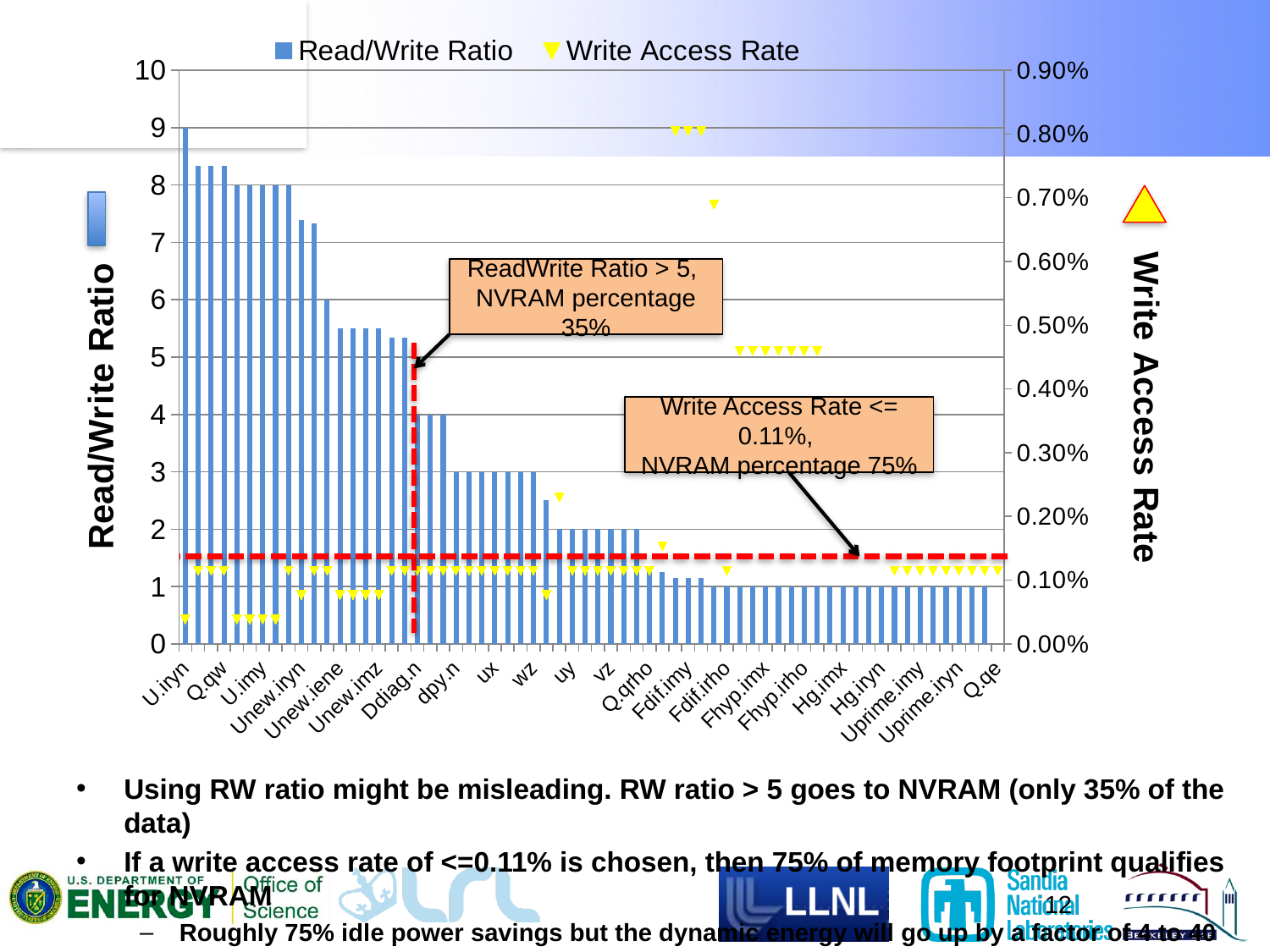
Do the Read/Write Ratio bars rise or fall from left to right along the x axis? fall How many series does the chart legend list? 2 Is the Read/Write Ratio for Q.qw greater or less than 8? greater Is the Read/Write Ratio for dpy.n greater or less than 5? less Is the Read/Write Ratio for U.iryn greater or less than 8? greater Which has the larger Read/Write Ratio, Q.qw or Q.qe? Q.qw Which category has the highest Read/Write Ratio bar? U.iryn What is the title of the right-hand vertical axis? Write Access Rate What kind of chart is shown on the slide? bar chart Which has the larger Read/Write Ratio, U.iryn or Q.qe? U.iryn What are the two series named in the chart legend? Read/Write Ratio and Write Access Rate